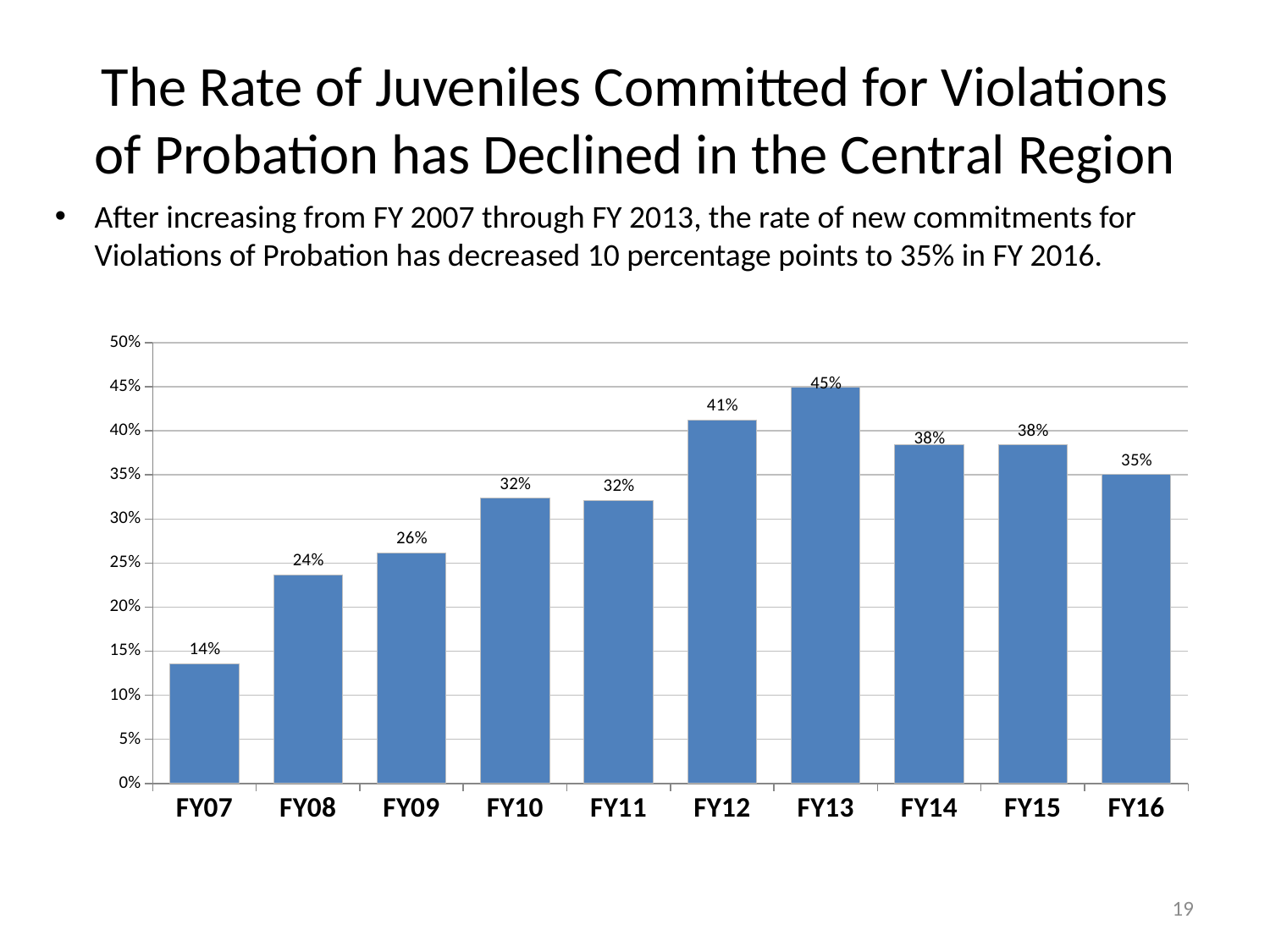
Do the values rise or fall from FY07 to FY13? rise What kind of chart is shown on the slide? bar chart How many fiscal years are shown on the x axis? 10 Which fiscal year has the lowest value? FY07 What is the value for FY07? 14% Is the value for FY08 greater or less than 25%? less Which is larger, the value for FY12 or the value for FY14? FY12 Which fiscal year has the highest value? FY13 What is the difference between the values for FY13 and FY16? 10% What is the value for FY16? 35% What is the value for FY09? 26% What is the value for FY13? 45%